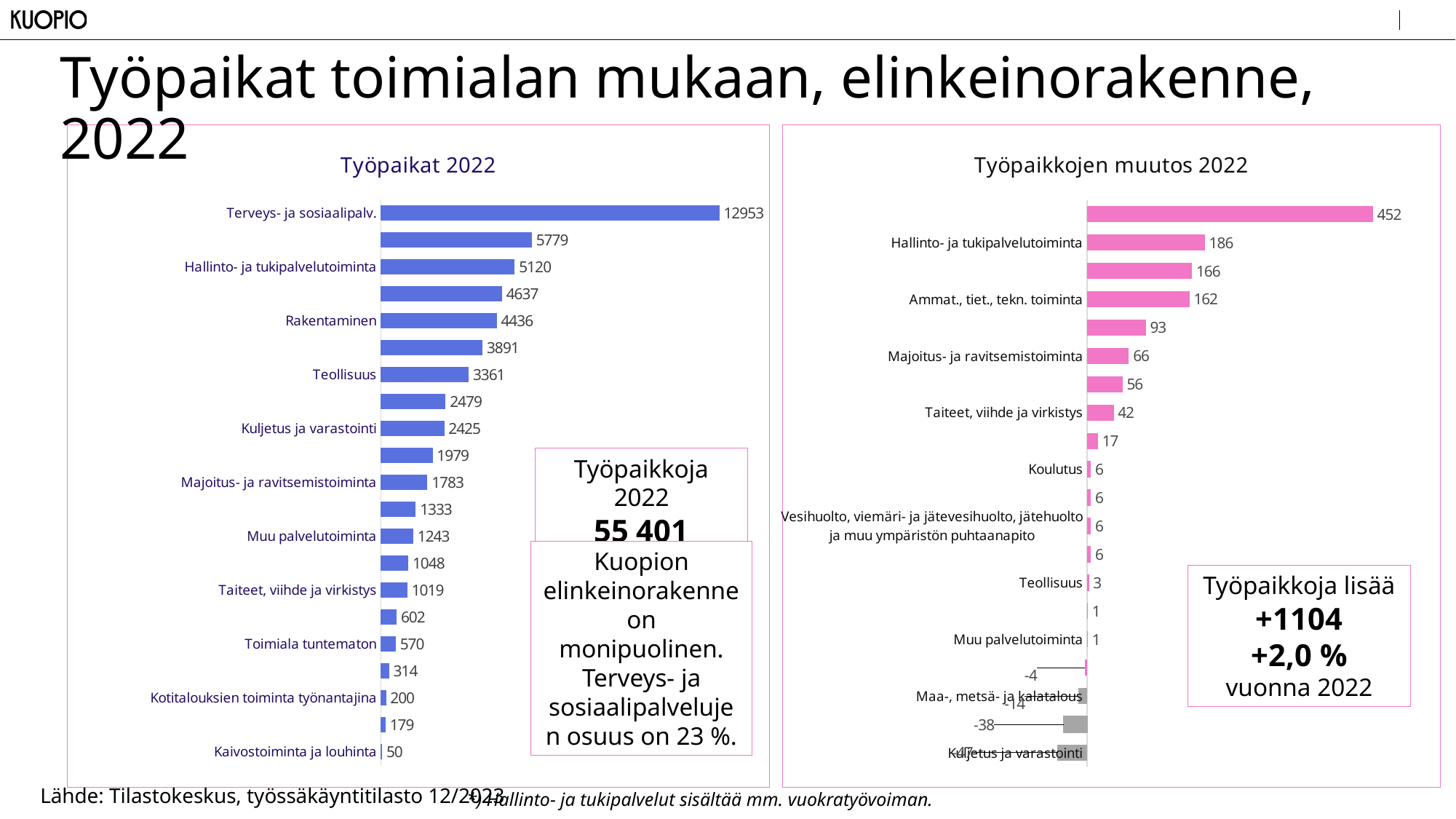
In the chart titled "Työpaikat 2022", how many bars are plotted? 21 In the chart titled "Työpaikkojen muutos 2022", what is the difference between Ammat., tiet., tekn. toiminta and Majoitus- ja ravitsemistoiminta? 96 In the chart titled "Työpaikat 2022", what is the value for Terveys- ja sosiaalipalv.? 12953 In the chart titled "Työpaikat 2022", what is the value for Rakentaminen? 4436 In the chart titled "Työpaikat 2022", what is the difference between Hallinto- ja tukipalvelutoiminta and Teollisuus? 1759 In the chart titled "Työpaikat 2022", which category has the lowest value? Kaivostoiminta ja louhinta What type of chart is the chart titled "Työpaikkojen muutos 2022"? Bar chart In the chart titled "Työpaikat 2022", what is the value for Kaivostoiminta ja louhinta? 50 In the chart titled "Työpaikkojen muutos 2022", what is the value for Taiteet, viihde ja virkistys? 42 In the chart titled "Työpaikkojen muutos 2022", what is the value for Hallinto- ja tukipalvelutoiminta? 186 What is the title of the chart on the left side of the slide? Työpaikat 2022 In the chart titled "Työpaikat 2022", which is larger: Kuljetus ja varastointi or Majoitus- ja ravitsemistoiminta? Kuljetus ja varastointi